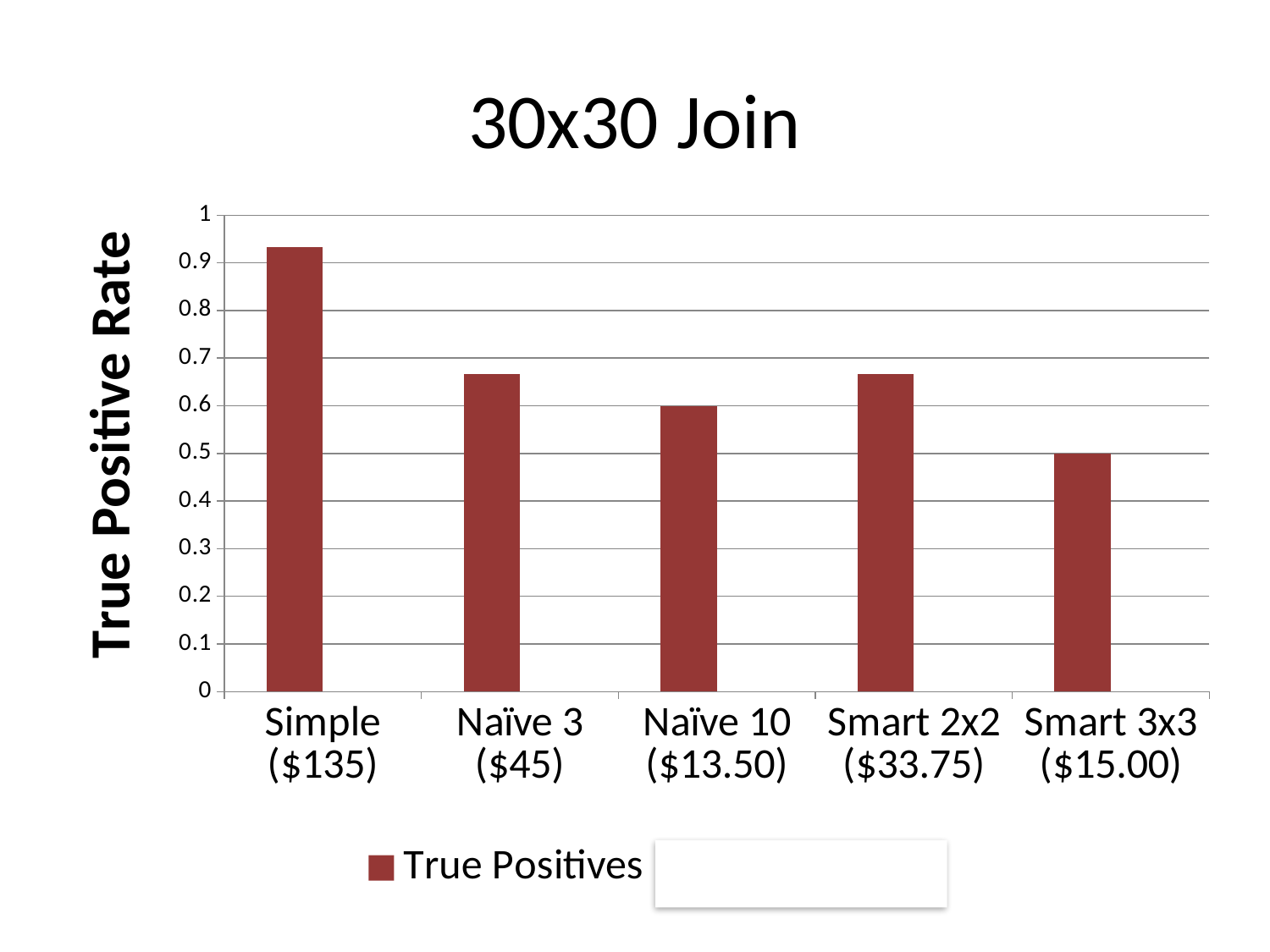
Which has a higher true positive rate, Simple ($135) or Naïve 3 ($45)? Simple ($135) How many categories are plotted on the x axis? 5 What is the true positive rate for Naïve 10 ($13.50)? 0.6 What is the title of the chart? 30x30 Join Which category has the highest true positive rate? Simple ($135) What kind of chart is shown on the slide? bar chart What is the label on the vertical axis? True Positive Rate Which category has the lowest true positive rate? Smart 3x3 ($15.00) What is the difference between the true positive rates of Naïve 10 ($13.50) and Smart 3x3 ($15.00)? 0.1 What is the true positive rate for Smart 3x3 ($15.00)? 0.5 Is the value for Simple ($135) greater or less than 0.9? greater